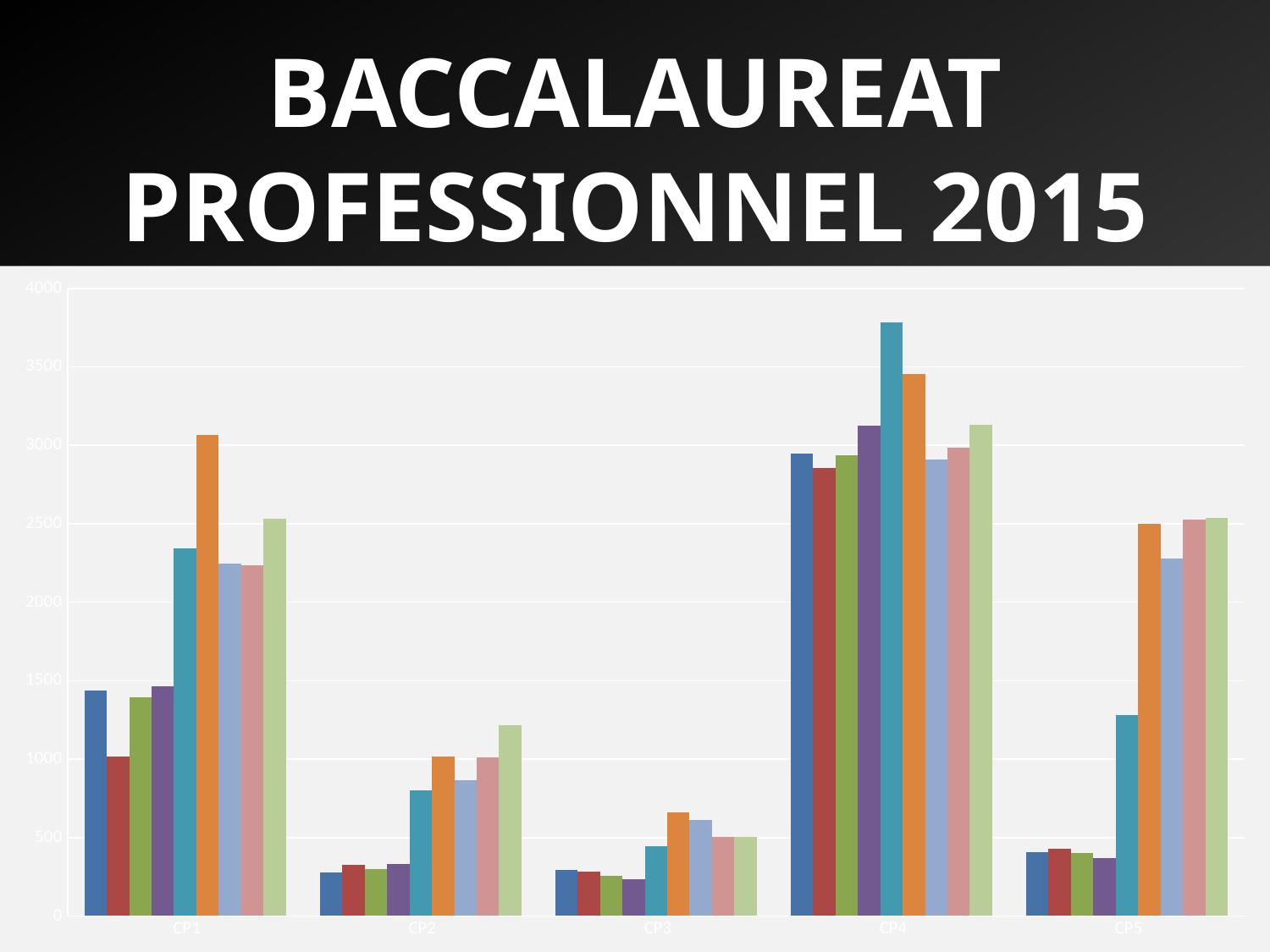
How many categories are shown on the x axis of the chart? 5 Which category has the taller maximum bar, CP2 or CP3? CP2 How many bars are plotted for each category in the chart? 9 Is the tallest bar in CP1 greater or less than 3000? greater Is the shortest bar in CP4 greater or less than 2500? greater Is the tallest bar in CP3 greater or less than 1000? less Which category contains the tallest bar in the chart? CP4 What is the title shown above the chart on the slide? BACCALAUREAT PROFESSIONNEL 2015 What kind of chart is shown on the slide? bar chart Which category has the lowest bars overall in the chart? CP3